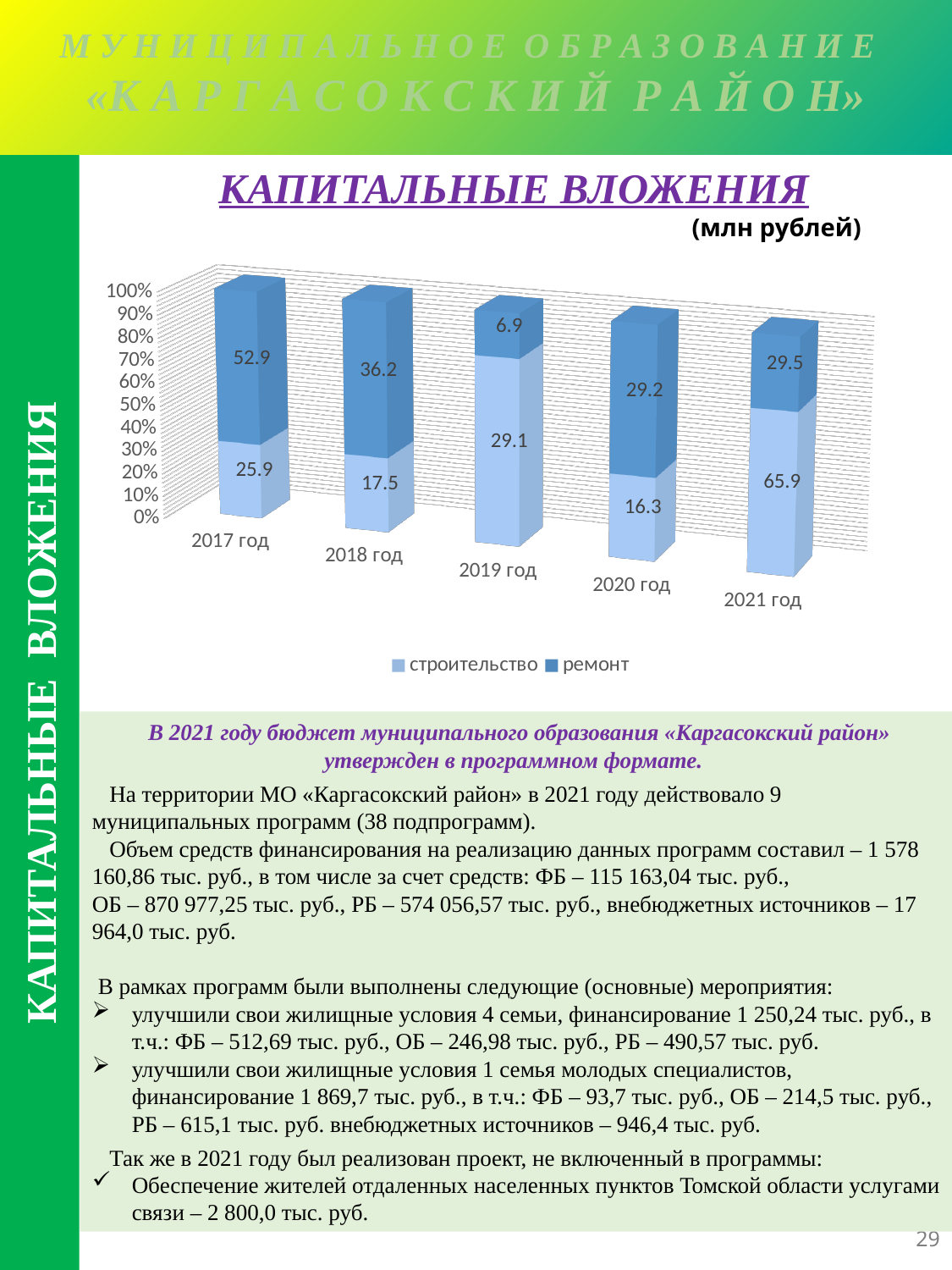
In which year is the value for ремонт the lowest? 2019 год Which is larger in 2020 год: строительство or ремонт? ремонт What is the value for строительство in 2017 год? 25.9 What is the difference between ремонт and строительство in 2017 год? 27.0 How many years are shown on the x axis? 5 What is the value for ремонт in 2018 год? 36.2 In which year is the value for строительство the highest? 2021 год How many series does the legend list? 2 What is the value for ремонт in 2019 год? 6.9 What is the value for строительство in 2021 год? 65.9 What kind of chart is shown on the slide? Stacked bar chart What is the total of строительство and ремонт in 2021 год? 95.4